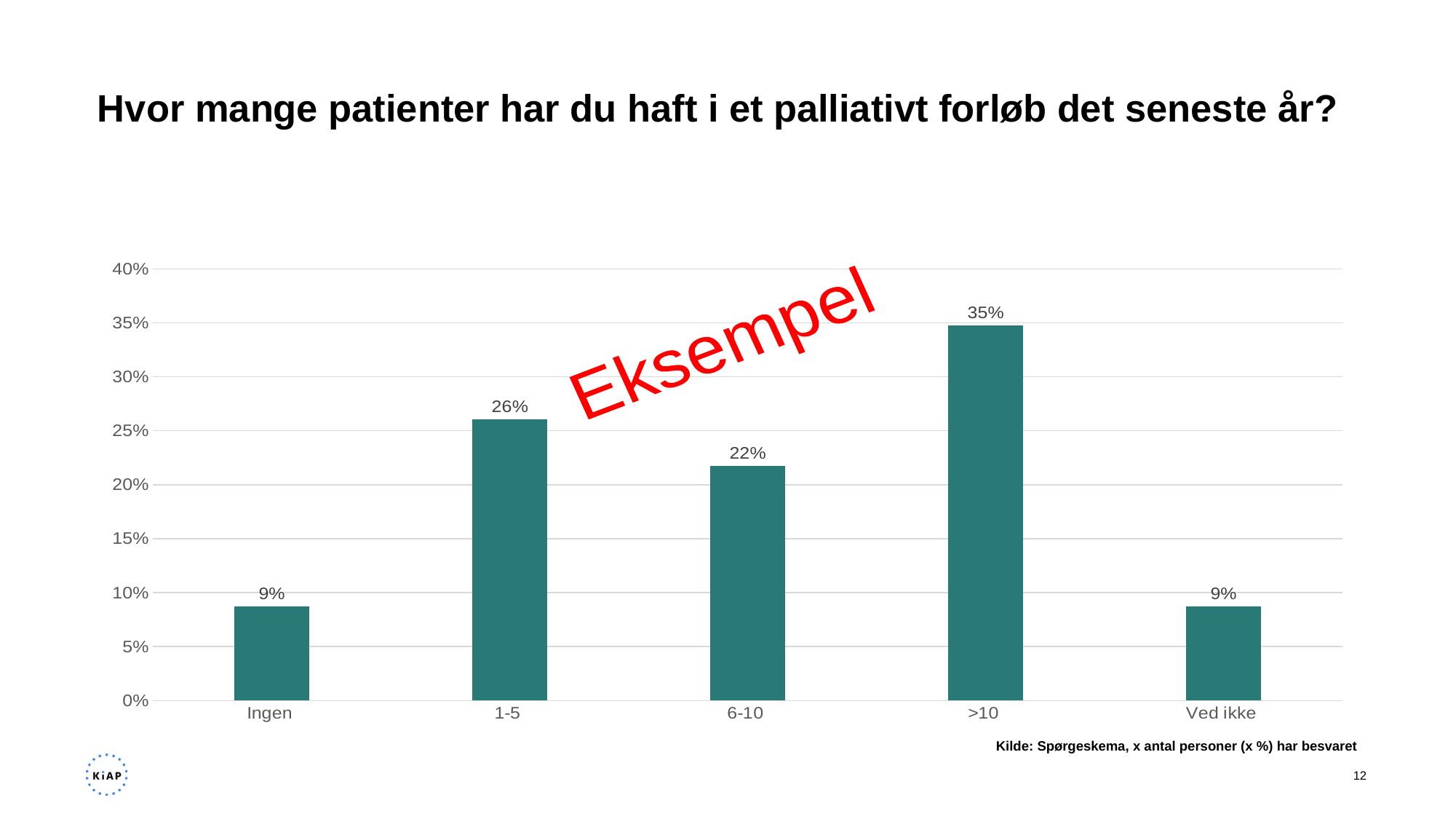
How many categories are shown on the x axis? 5 What is the value for the "Ved ikke" category? 9% What is the value for the ">10" category? 35% What is the difference between the values for "1-5" and "6-10"? 4% What is the value for the "6-10" category? 22% Is the value for "Ingen" greater or less than 10%? less Which is larger, the value for "1-5" or the value for "6-10"? 1-5 Which category has the highest value? >10 What is the value for the "1-5" category? 26% What kind of chart is shown on the slide? bar chart What is the difference between the values for ">10" and "1-5"? 9% What is the title of the chart? Hvor mange patienter har du haft i et palliativt forløb det seneste år?